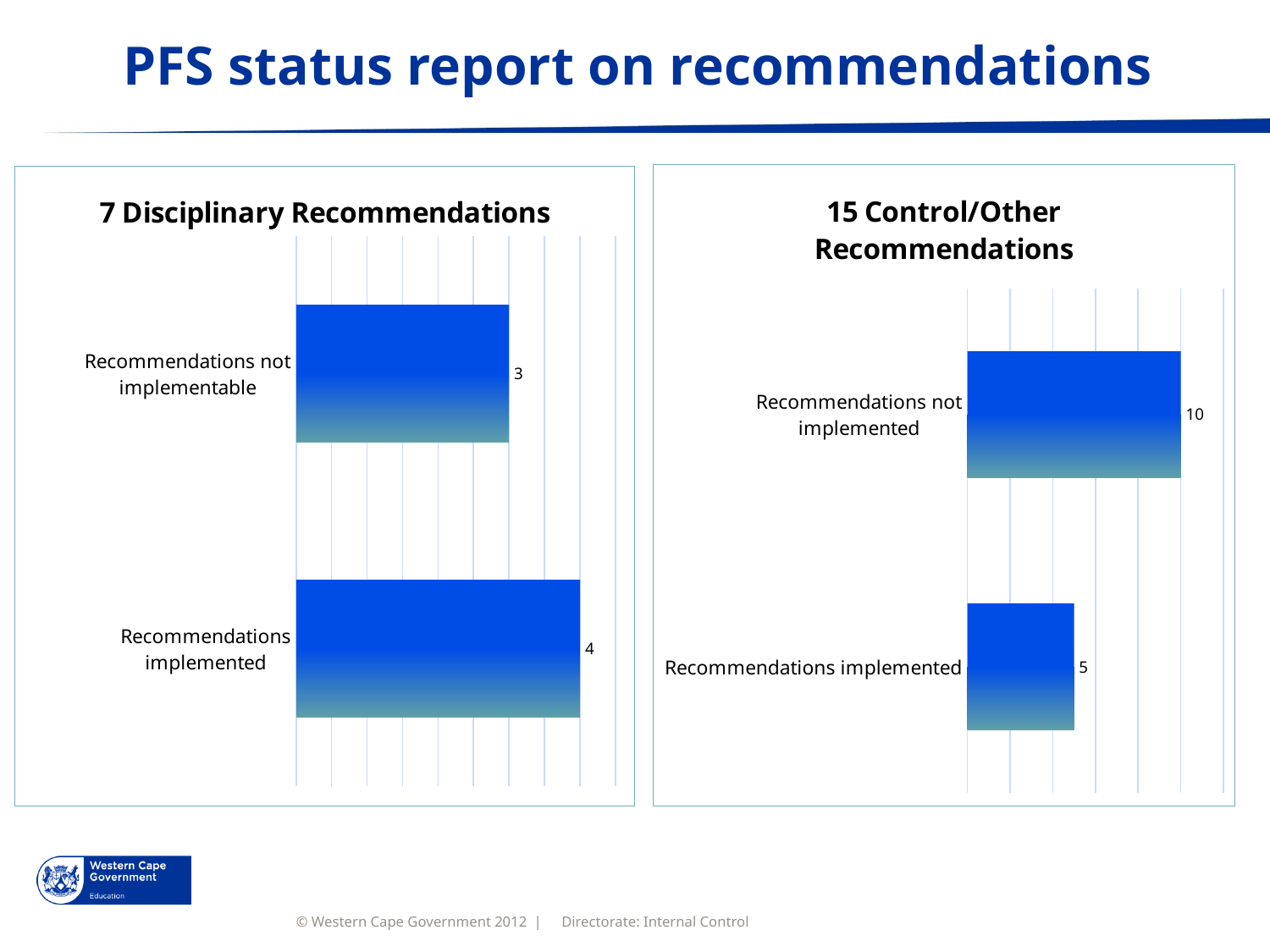
In the '7 Disciplinary Recommendations' chart, which category has the higher value? Recommendations implemented In the '7 Disciplinary Recommendations' chart, what is the value for 'Recommendations not implementable'? 3 In the '7 Disciplinary Recommendations' chart, what is the difference between 'Recommendations implemented' and 'Recommendations not implementable'? 1 Is the value for 'Recommendations implemented' larger in the '7 Disciplinary Recommendations' chart or in the '15 Control/Other Recommendations' chart? 15 Control/Other Recommendations In the '15 Control/Other Recommendations' chart, what is the difference between 'Recommendations not implemented' and 'Recommendations implemented'? 5 How many categories are shown in the '15 Control/Other Recommendations' chart? 2 What is the title of the chart on the right side of the slide? 15 Control/Other Recommendations What type of chart is the '7 Disciplinary Recommendations' chart? Bar chart In the '7 Disciplinary Recommendations' chart, what is the value for 'Recommendations implemented'? 4 In the '15 Control/Other Recommendations' chart, what is the value for 'Recommendations not implemented'? 10 In the '15 Control/Other Recommendations' chart, which category has the lowest value? Recommendations implemented In the '15 Control/Other Recommendations' chart, what is the value for 'Recommendations implemented'? 5